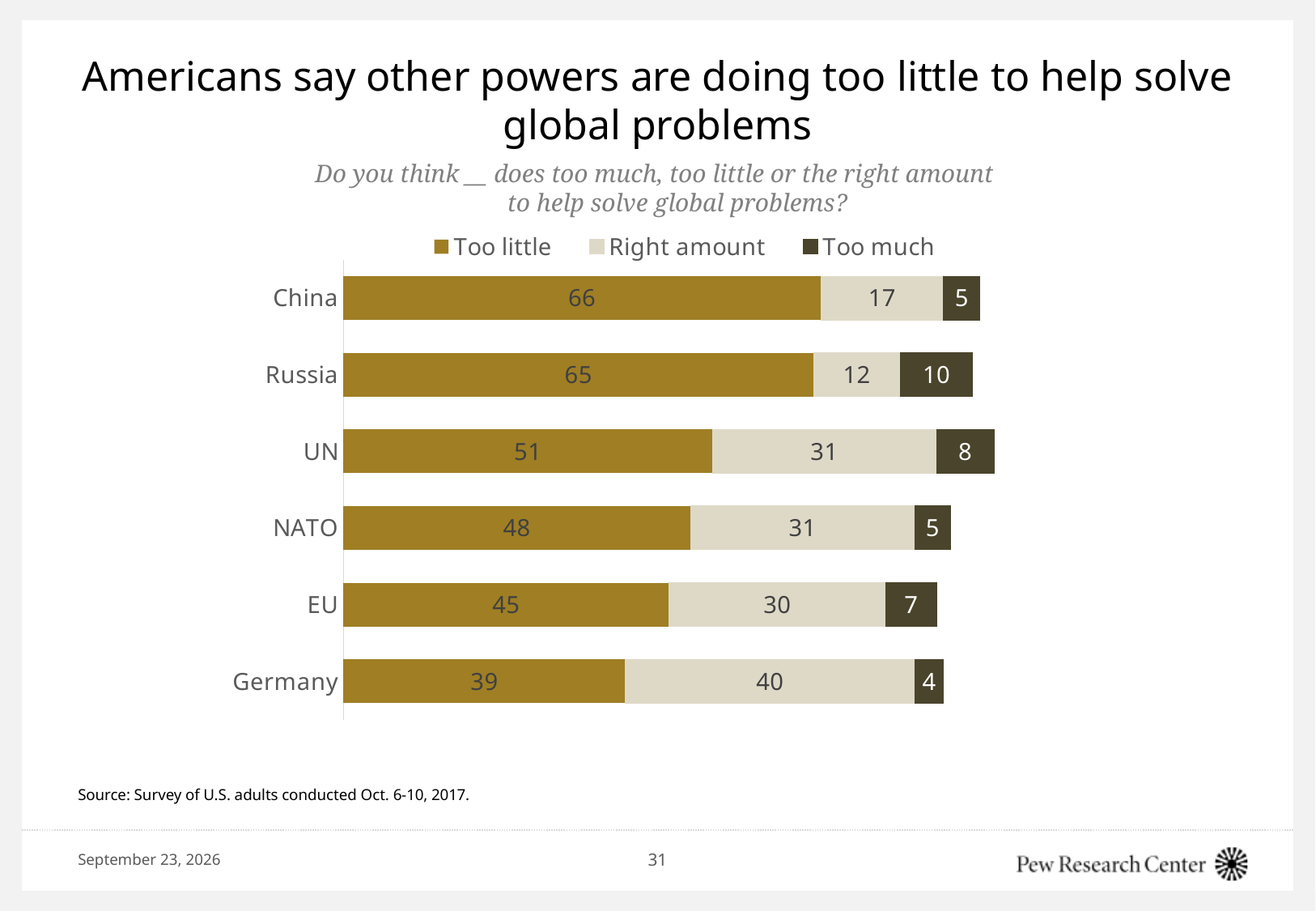
What is the 'Too little' value for China? 66 What is the total of the stacked bar for NATO? 84 How many series does the legend list? 3 What is the difference between the 'Too little' values for China and Germany? 27 Which category has the lowest 'Too much' value? Germany Which category has the highest 'Too little' value? China Which legend entry is shown in the darkest colour? Too much What is the 'Too much' value for Russia? 10 What is the 'Right amount' value for Germany? 40 What kind of chart is shown on the slide? Stacked bar chart Which is larger: the 'Right amount' value for UN or for Russia? UN How many categories are shown on the chart? 6